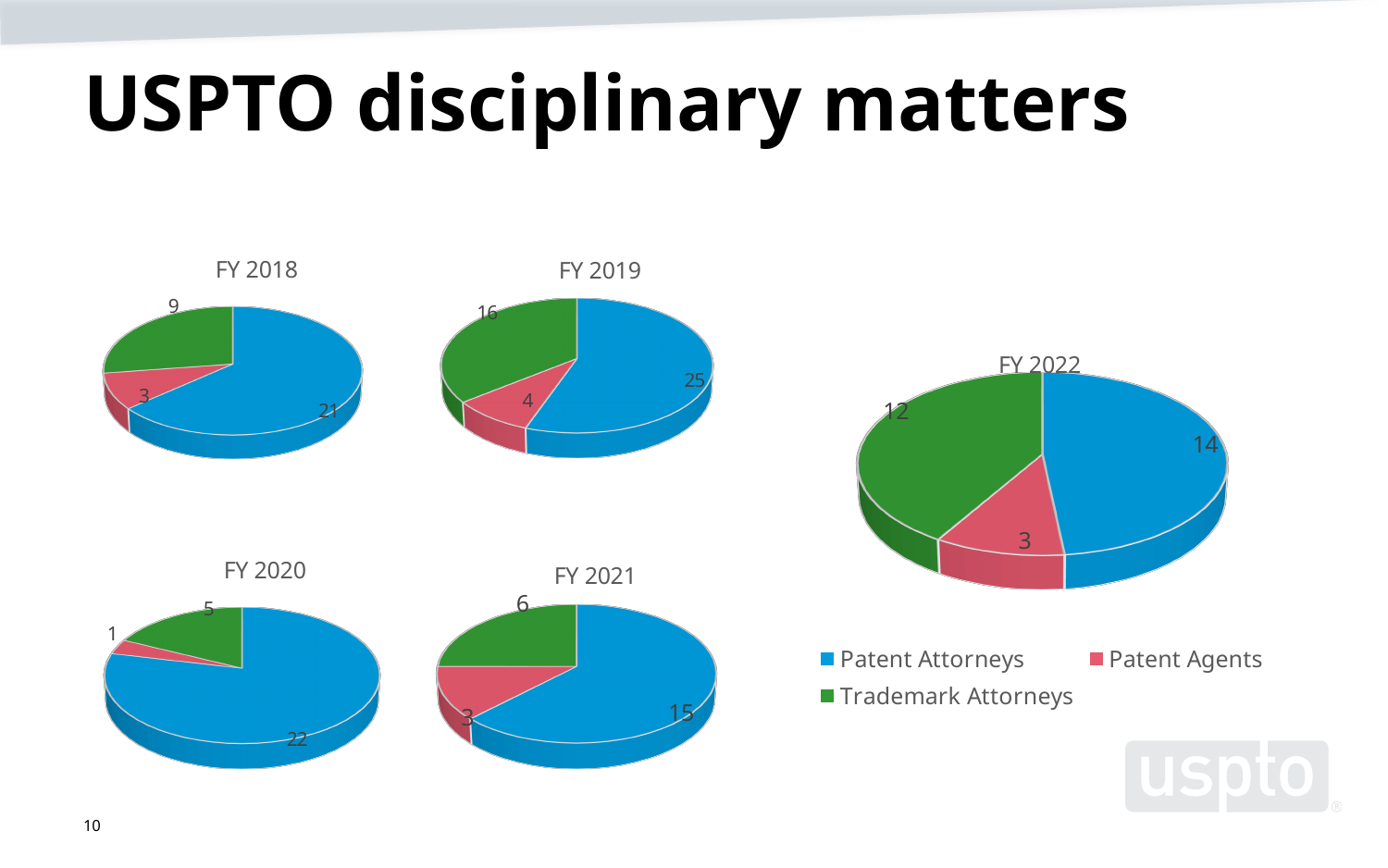
In the FY 2018 chart, what is the value for Patent Attorneys? 21 What kind of chart is the FY 2022 chart? Pie chart In the FY 2020 chart, what is the value for Patent Agents? 1 In the FY 2019 chart, what is the difference between the Patent Attorneys value and the Trademark Attorneys value? 9 In the FY 2022 chart, which category has the smallest slice? Patent Agents In the FY 2021 chart, which category has the largest slice? Patent Attorneys What share of the FY 2021 pie does the Patent Attorneys slice represent? 62.5% Is the Patent Attorneys value larger in the FY 2018 chart or the FY 2022 chart? FY 2018 In the FY 2022 chart, what is the value for Trademark Attorneys? 12 What is the total of all slices in the FY 2020 chart? 28 In the FY 2019 chart, what is the value for Trademark Attorneys? 16 How many series does the legend list? 3